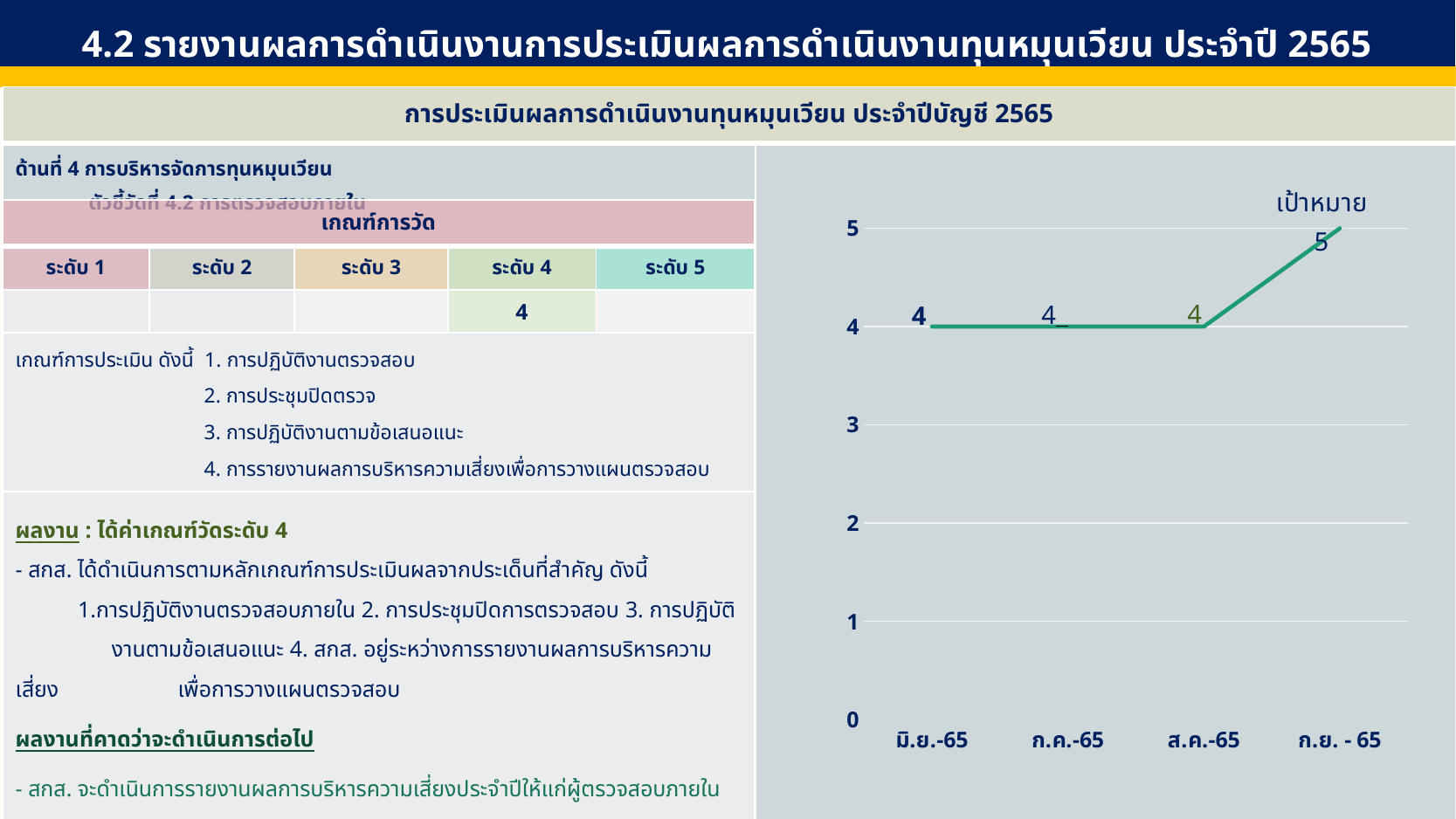
Do the values in the line chart rise or fall from ส.ค.-65 to ก.ย. - 65? rise What is the value for มิ.ย.-65 in the line chart? 4 What is the value for ก.ย. - 65 in the line chart? 5 What is the value for ก.ค.-65 in the line chart? 4 What is the difference between the values for ก.ย. - 65 and ส.ค.-65 in the line chart? 1 What is the value for ส.ค.-65 in the line chart? 4 What is the highest value shown on the y axis of the line chart? 5 How many data points are plotted in the line chart? 4 What kind of chart is shown on the right side of the slide? line chart What label appears next to the last point of the line chart? เป้าหมาย Which is larger in the line chart, the value for ก.ย. - 65 or the value for มิ.ย.-65? ก.ย. - 65 Which month has the highest value in the line chart? ก.ย. - 65